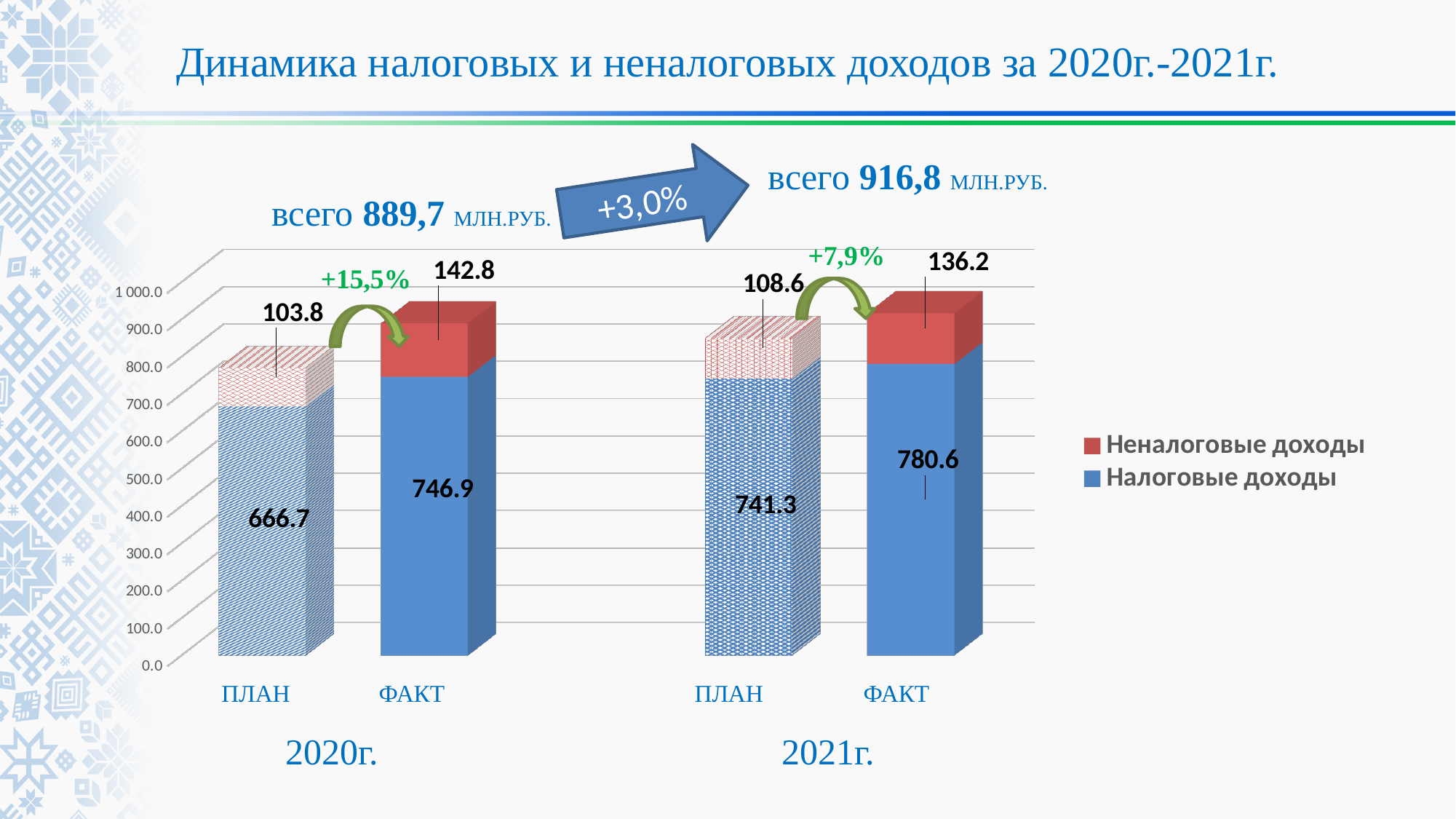
What is the value of Налоговые доходы for ФАКТ 2021г.? 780.6 How many bars are plotted in the chart? 4 What is the value of Неналоговые доходы for ФАКТ 2020г.? 142.8 What type of chart is shown on the slide? Stacked bar chart What is the value of Налоговые доходы for ПЛАН 2020г.? 666.7 Which bar has the highest value of Налоговые доходы? ФАКТ 2021г. Which colour represents Неналоговые доходы in the legend? Red How many series does the legend list? 2 What is the difference between Налоговые доходы for ФАКТ 2020г. and ПЛАН 2020г.? 80.2 Which bar has the lowest value of Неналоговые доходы? ПЛАН 2020г. What is the value of Неналоговые доходы for ПЛАН 2021г.? 108.6 What is the total of the stacked bar for ПЛАН 2021г.? 849.9